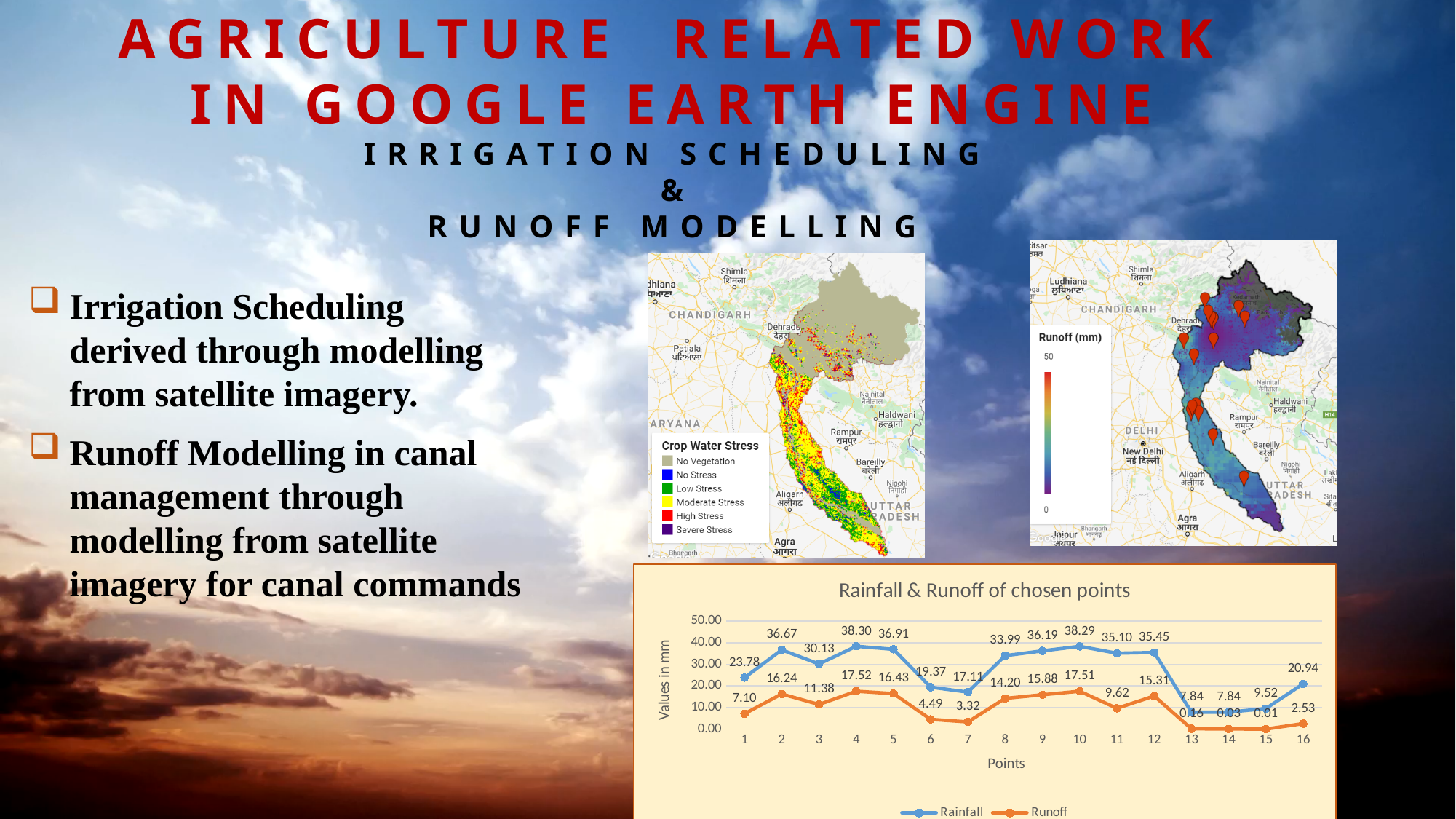
What is the difference between Rainfall and Runoff at point 1? 16.68 What is the difference between Rainfall and Runoff at point 16? 18.41 What kind of chart is shown on the slide? Line chart Is the Rainfall value at point 13 greater or less than 10.00? less What is the Runoff value at point 7? 3.32 Which is larger, the Rainfall value at point 2 or at point 3? Point 2 What is the Rainfall value at point 16? 20.94 What is the Runoff value at point 10? 17.51 How many points are plotted along the x axis of the chart? 16 How many series does the chart legend list? 2 What is the Rainfall value at point 1? 23.78 What is the title of the chart? Rainfall & Runoff of chosen points